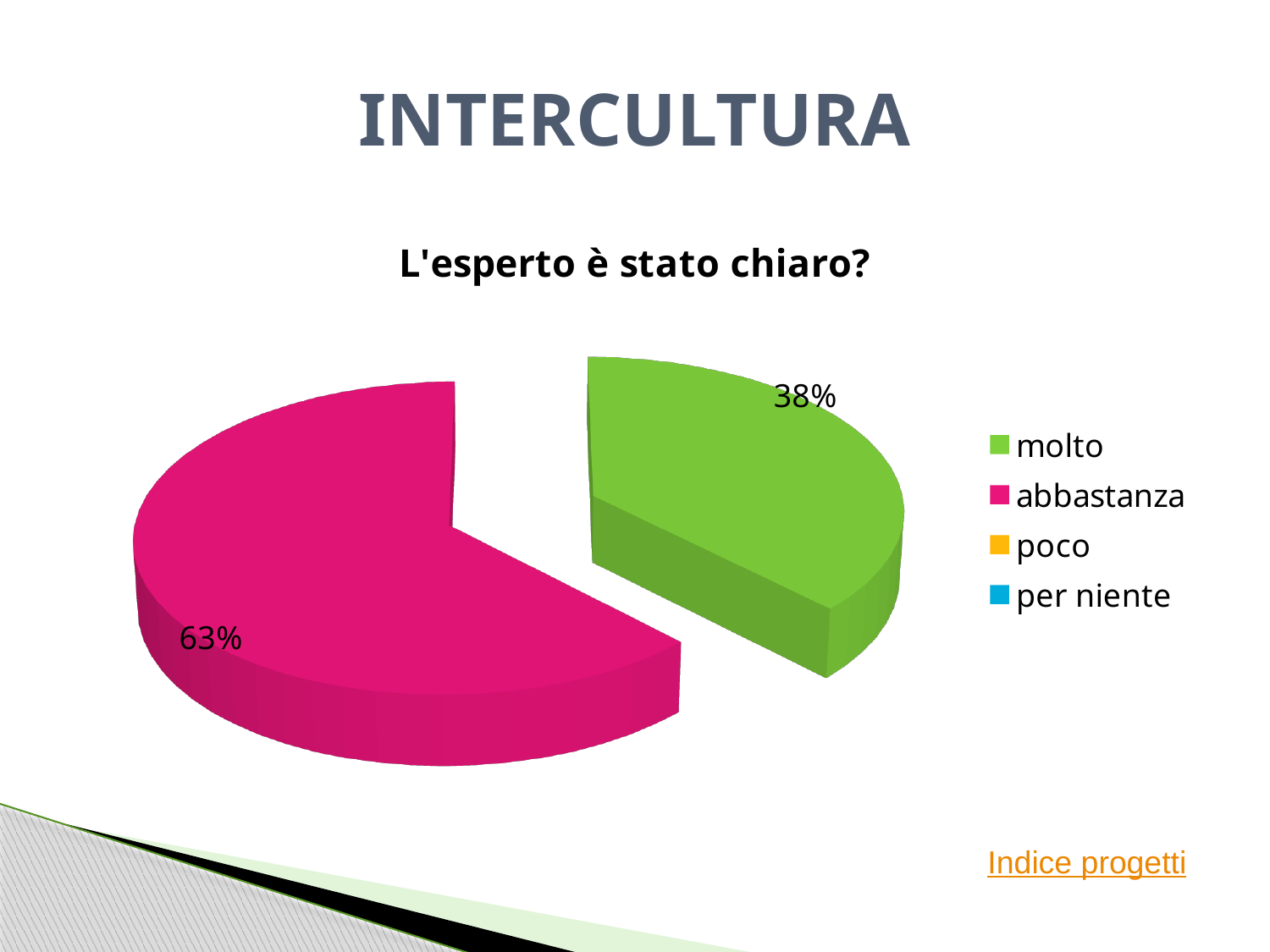
What kind of chart is shown on the slide? pie chart What is the difference in percentage points between the "abbastanza" and "molto" slices? 25 Which category has the largest slice of the pie? abbastanza How many entries does the legend list? 4 What percentage of the pie is labelled for "molto"? 38% What share of the pie does "molto" represent? 38% What colour is the slice for "molto"? green Which of the two visible slices is smaller, "molto" or "abbastanza"? molto Is the slice for "abbastanza" larger or smaller than the slice for "molto"? larger How many slices with data labels are visible in the pie? 2 What percentage of the pie is labelled for "abbastanza"? 63% What is the chart's title? L'esperto è stato chiaro?